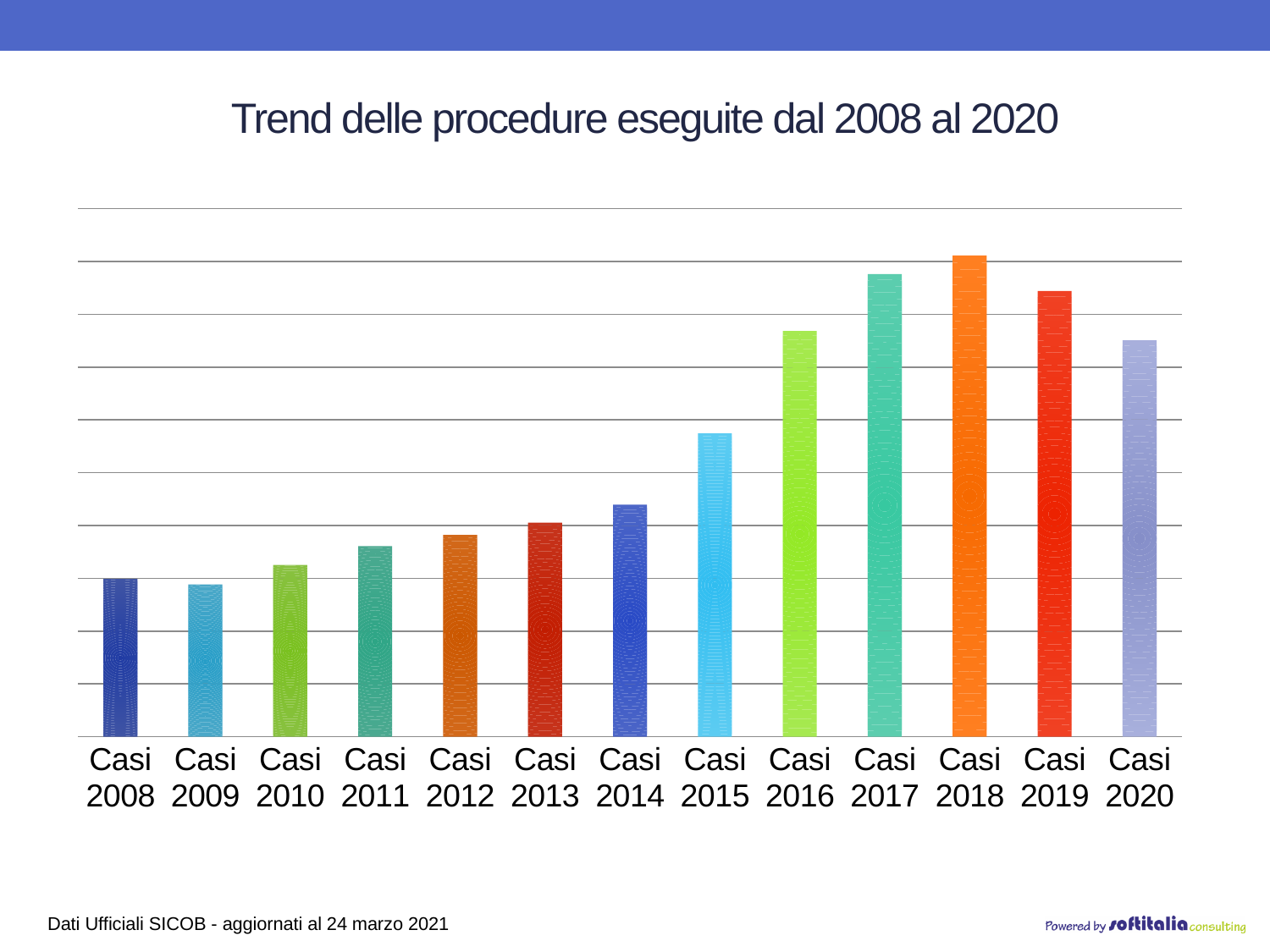
Which is larger, the value for Casi 2014 or Casi 2015? Casi 2015 Which category has the lowest bar among Casi 2016 to Casi 2020? Casi 2020 Which is larger, the value for Casi 2020 or Casi 2019? Casi 2019 What is the title of the chart? Trend delle procedure eseguite dal 2008 al 2020 Which is larger, the value for Casi 2017 or Casi 2019? Casi 2017 How many categories are shown on the x axis? 13 Do the values generally rise or fall from Casi 2008 to Casi 2018? Rise Do the values rise or fall from Casi 2018 to Casi 2020? Fall What kind of chart is shown on the slide? Bar chart Which category has the highest bar? Casi 2018